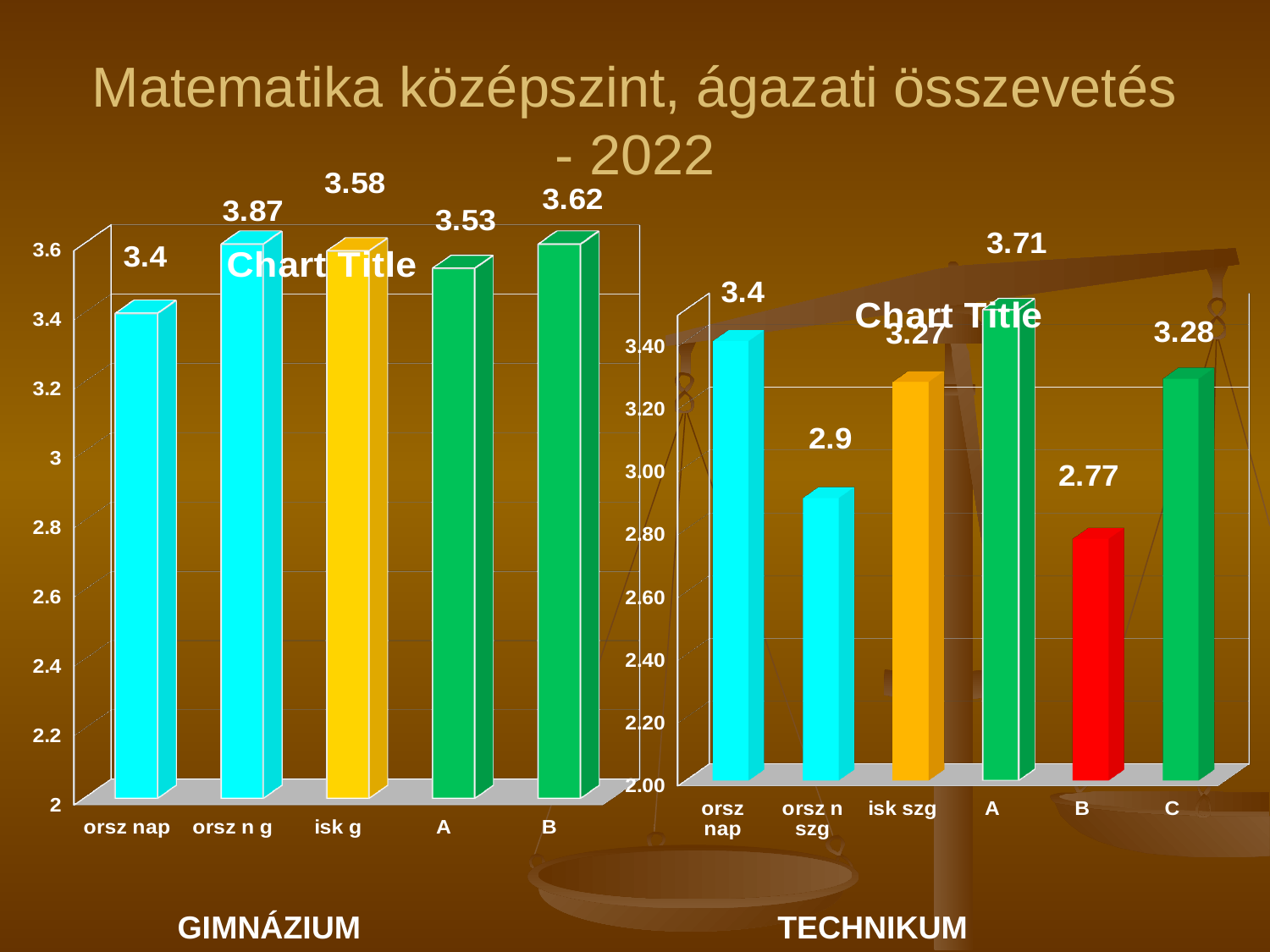
In the TECHNIKUM chart on the right, which category has the highest value? A In the GIMNÁZIUM chart on the left, which category has the lowest value? orsz nap In the TECHNIKUM chart on the right, which is larger, the value for orsz n szg or the value for C? C How many categories are shown in the TECHNIKUM chart on the right? 6 In the TECHNIKUM chart on the right, what is the value for B? 2.77 In the TECHNIKUM chart on the right, which category has the lowest value? B In the TECHNIKUM chart on the right, what is the value for isk szg? 3.27 In the GIMNÁZIUM chart on the left, what is the difference between the values for B and A? 0.09 In the GIMNÁZIUM chart on the left, what is the value for orsz n g? 3.87 In the GIMNÁZIUM chart on the left, what is the value for A? 3.53 In the GIMNÁZIUM chart on the left, which category has the highest value? orsz n g How many categories are shown in the GIMNÁZIUM chart on the left? 5